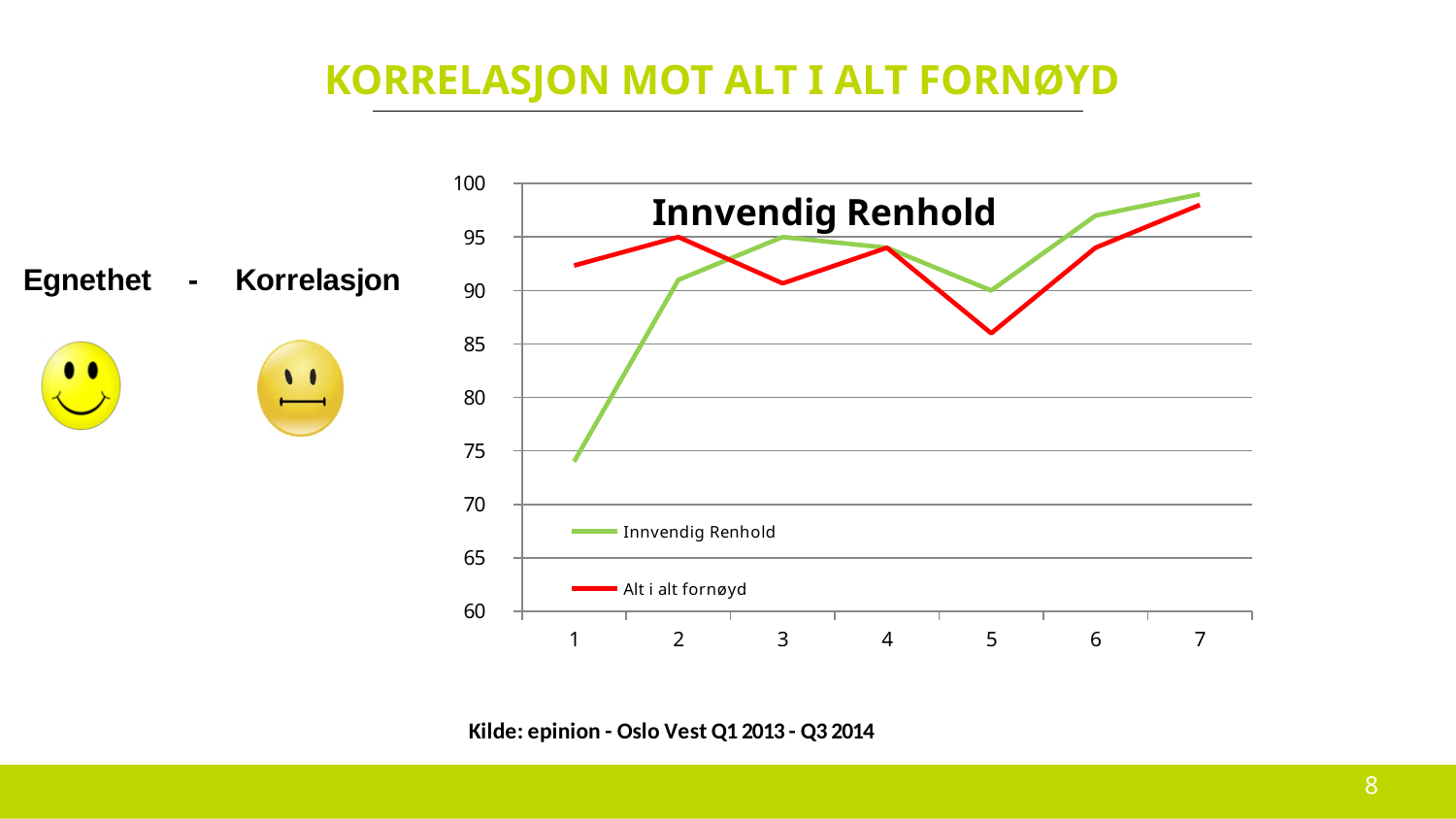
At which x-axis point is the 'Alt i alt fornøyd' series lowest? 5 Is the value of 'Alt i alt fornøyd' at point 5 greater or less than 90? less At which x-axis point is the 'Innvendig Renhold' series lowest? 1 Is the value of 'Innvendig Renhold' at point 7 greater or less than 95? greater What kind of chart is shown on the slide? line chart How many points are plotted along the x axis for each series? 7 What is the title of the chart? Innvendig Renhold Which colour is used for the 'Alt i alt fornøyd' series? red Is the value of 'Innvendig Renhold' at point 1 greater or less than 80? less Do the values of 'Innvendig Renhold' rise or fall from point 5 to point 7? rise At point 1, which series has the higher value, 'Innvendig Renhold' or 'Alt i alt fornøyd'? Alt i alt fornøyd How many series does the chart's legend list? 2